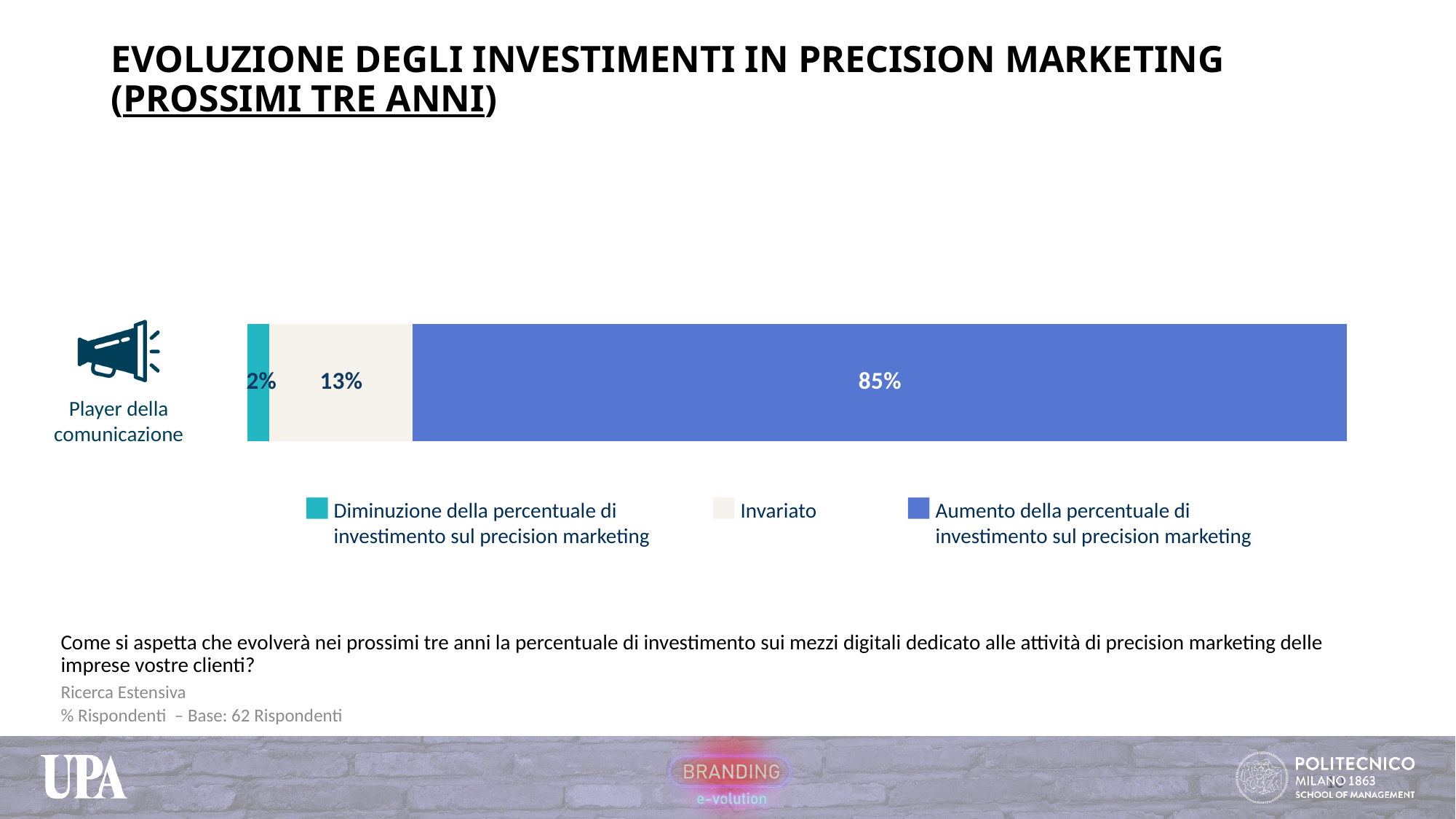
How many series does the legend list? 3 What percentage of respondents expect a decrease in the share of investment in precision marketing (Diminuzione della percentuale di investimento sul precision marketing)? 2% What is the label of the category shown next to the bar? Player della comunicazione What is the difference in percentage points between 'Aumento' and 'Invariato'? 72 Which response option has the highest percentage? Aumento della percentuale di investimento sul precision marketing What is the total of the three segments in the stacked bar? 100% What percentage of respondents expect an increase in the share of investment in precision marketing (Aumento della percentuale di investimento sul precision marketing)? 85% Which is larger: the percentage for 'Invariato' or for 'Diminuzione'? Invariato What kind of chart is shown on the slide? Stacked bar chart What is the difference in percentage points between 'Invariato' and 'Diminuzione'? 11 Which response option has the lowest percentage? Diminuzione della percentuale di investimento sul precision marketing What percentage of respondents expect the share of investment to remain unchanged (Invariato)? 13%